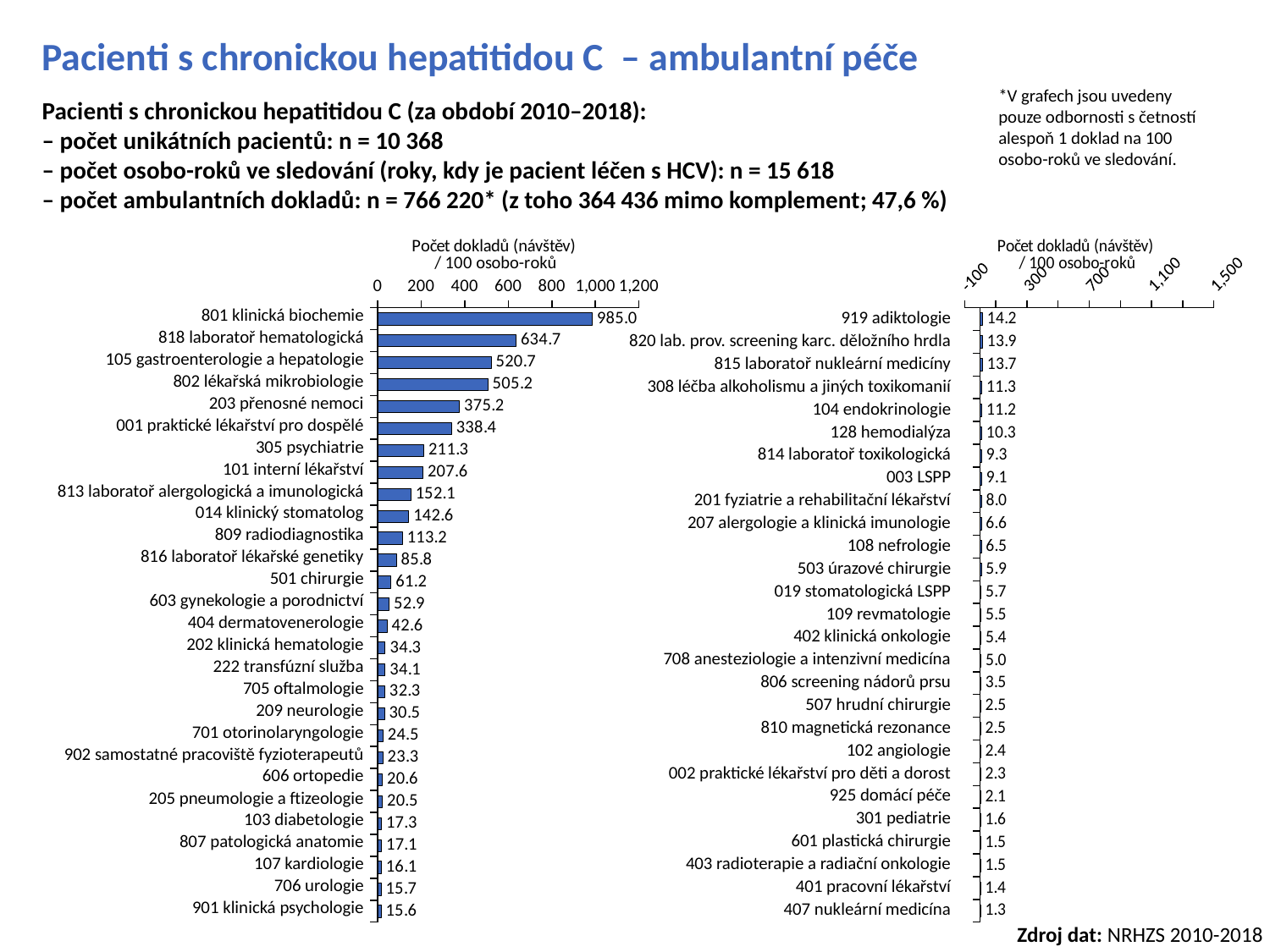
In the left chart, which is larger: the value for 203 přenosné nemoci or the value for 001 praktické lékařství pro dospělé? 203 přenosné nemoci In the left chart, is the value for 802 lékařská mikrobiologie greater or less than 400? greater In the left chart, which category has the lowest value? 901 klinická psychologie In the right chart, what is the value for 128 hemodialýza? 10.3 In the right chart, which category has the highest value? 919 adiktologie In the left chart, what is the difference between the values for 818 laboratoř hematologická and 105 gastroenterologie a hepatologie? 114.0 In the left chart, what is the value for 305 psychiatrie? 211.3 In the right chart, what is the difference between the values for 919 adiktologie and 407 nukleární medicína? 12.9 What is the axis title shown above the left chart? Počet dokladů (návštěv) / 100 osobo-roků In the left chart, what is the value for 801 klinická biochemie? 985.0 How many categories are shown in the left chart? 28 What kind of chart is the left chart? Bar chart